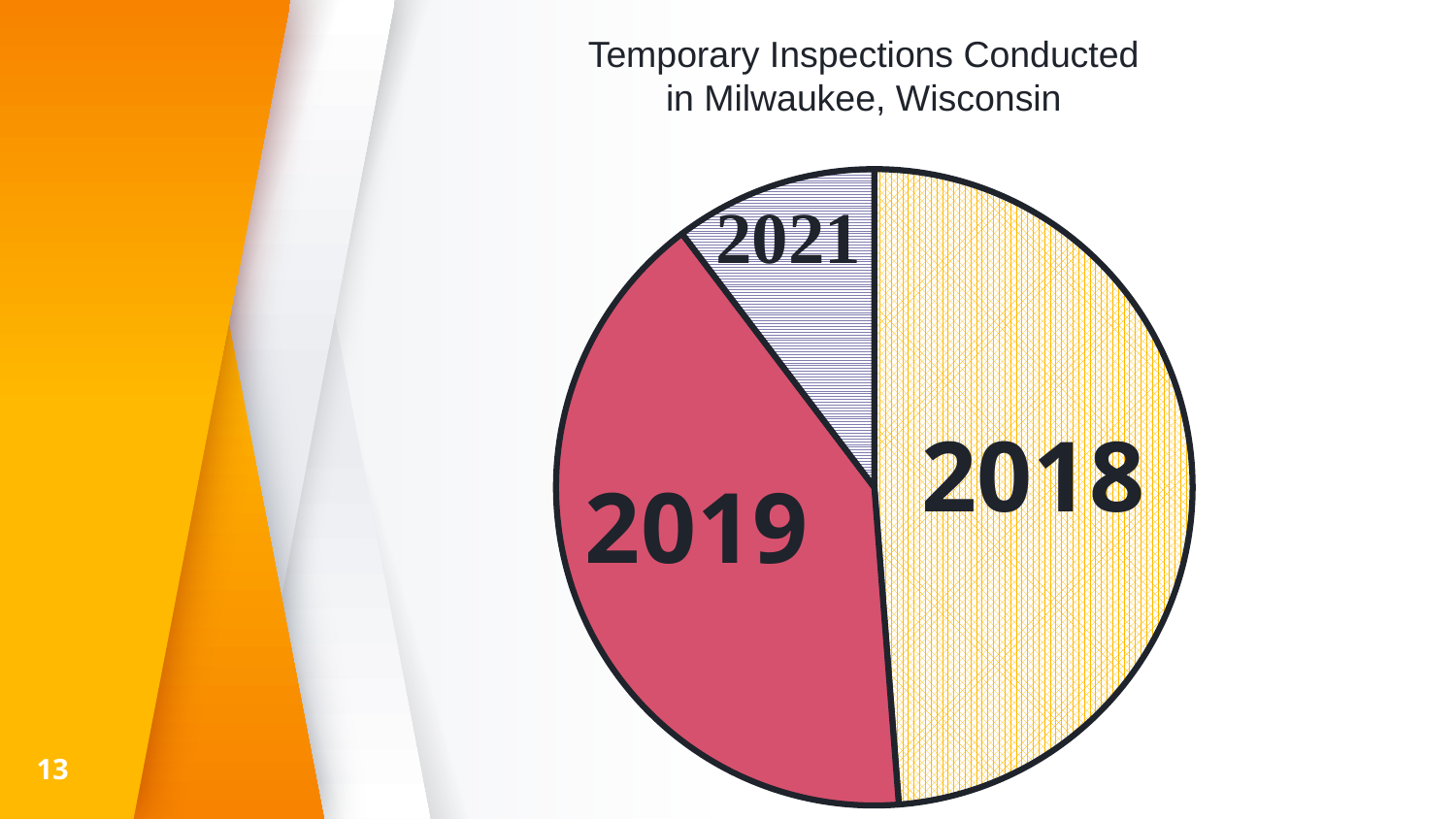
Which slice is larger, 2019 or 2021? 2019 Which slice is larger, 2018 or 2019? 2018 Which year has the largest slice of the pie chart? 2018 Which slice is smaller, 2018 or 2021? 2021 Which year's slice is filled with a solid red colour? 2019 Which years are labelled on the pie chart? 2018, 2019, 2021 Which year has the smallest slice of the pie chart? 2021 How many slices does the pie chart have? 3 What kind of chart is shown on the slide? Pie chart What is the title of the chart? Temporary Inspections Conducted in Milwaukee, Wisconsin